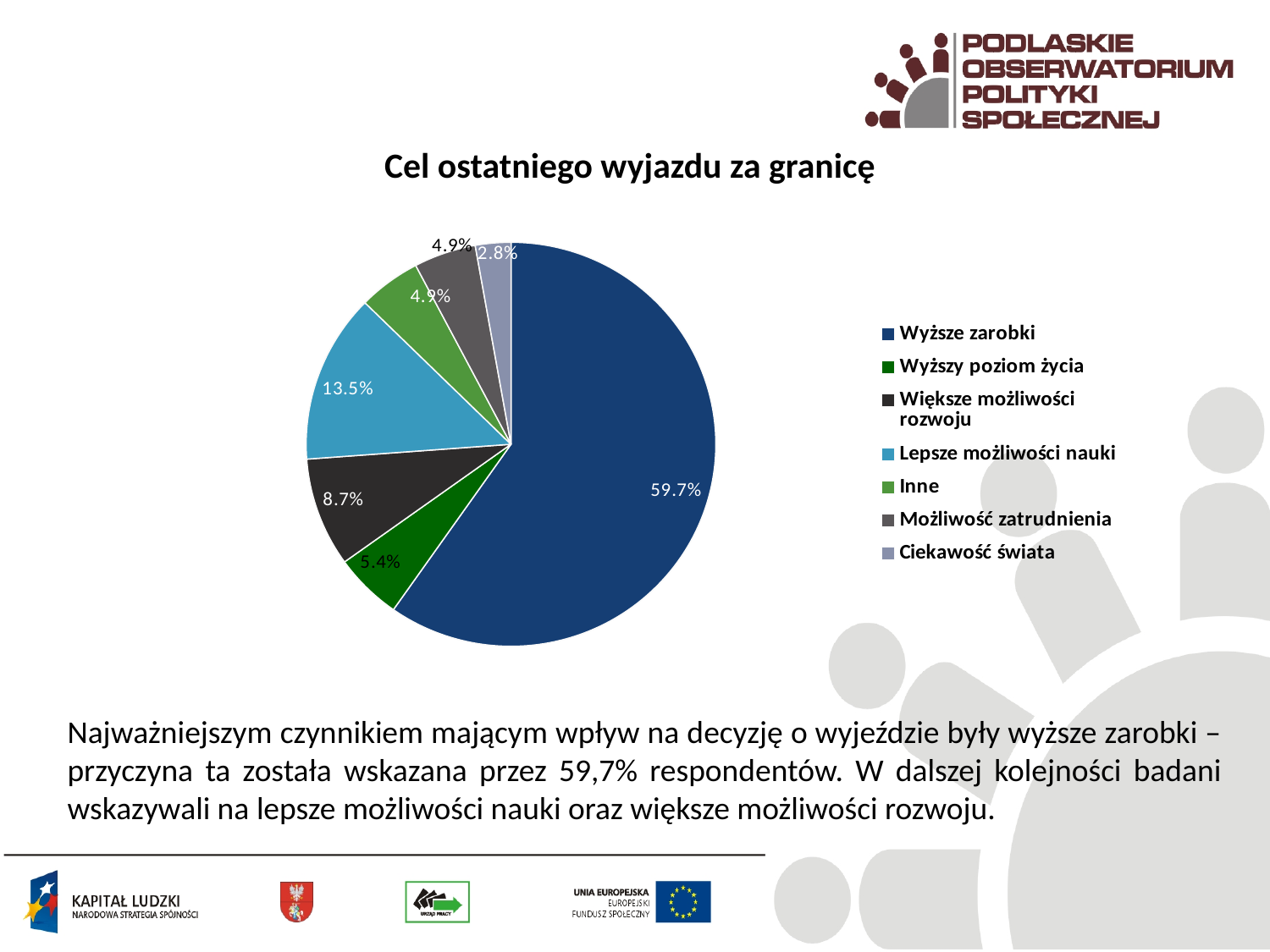
Which category has the largest slice of the pie? Wyższe zarobki What percentage is shown for Lepsze możliwości nauki? 13.5% What is the title of the chart? Cel ostatniego wyjazdu za granicę What percentage of the pie is labelled for Wyższe zarobki? 59.7% Which is larger, the slice for Wyższy poziom życia or the slice for Większe możliwości rozwoju? Większe możliwości rozwoju What percentage is shown for Większe możliwości rozwoju? 8.7% What is the difference in percentage points between Lepsze możliwości nauki and Większe możliwości rozwoju? 4.8 Which category has the smallest slice of the pie? Ciekawość świata What percentage is shown for Wyższy poziom życia? 5.4% What percentage is shown for Ciekawość świata? 2.8% What type of chart is shown on the slide? pie chart How many categories does the legend list? 7